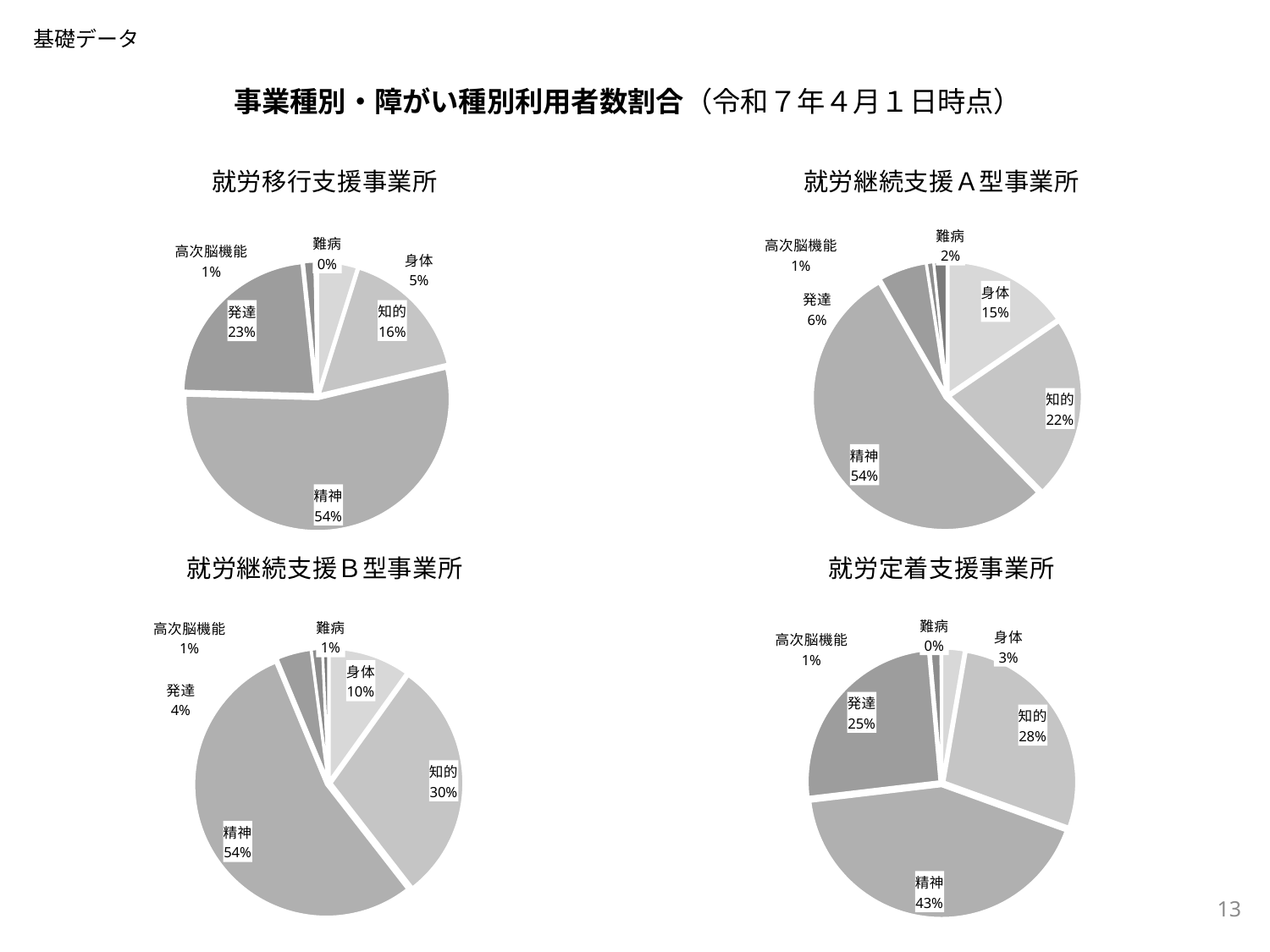
In the 就労継続支援Ｂ型事業所 pie chart, what share is 知的? 30% What kind of chart is used for 就労継続支援Ａ型事業所? Pie chart In the 就労定着支援事業所 pie chart, which is larger, 知的 or 発達? 知的 In the 就労継続支援Ａ型事業所 pie chart, what share is 難病? 2% In the 就労移行支援事業所 pie chart, what share is 発達? 23% In the 就労定着支援事業所 pie chart, what share is 精神? 43% In the 就労継続支援Ａ型事業所 pie chart, what share is 身体? 15% In the 就労継続支援Ｂ型事業所 pie chart, what is the difference between the shares of 精神 and 知的? 24% How many categories does the 就労移行支援事業所 pie chart show? 6 In the 就労継続支援Ａ型事業所 pie chart, which category has the smallest share? 高次脳機能 How many pie charts are on the slide? 4 In the 就労定着支援事業所 pie chart, which category has the largest share? 精神